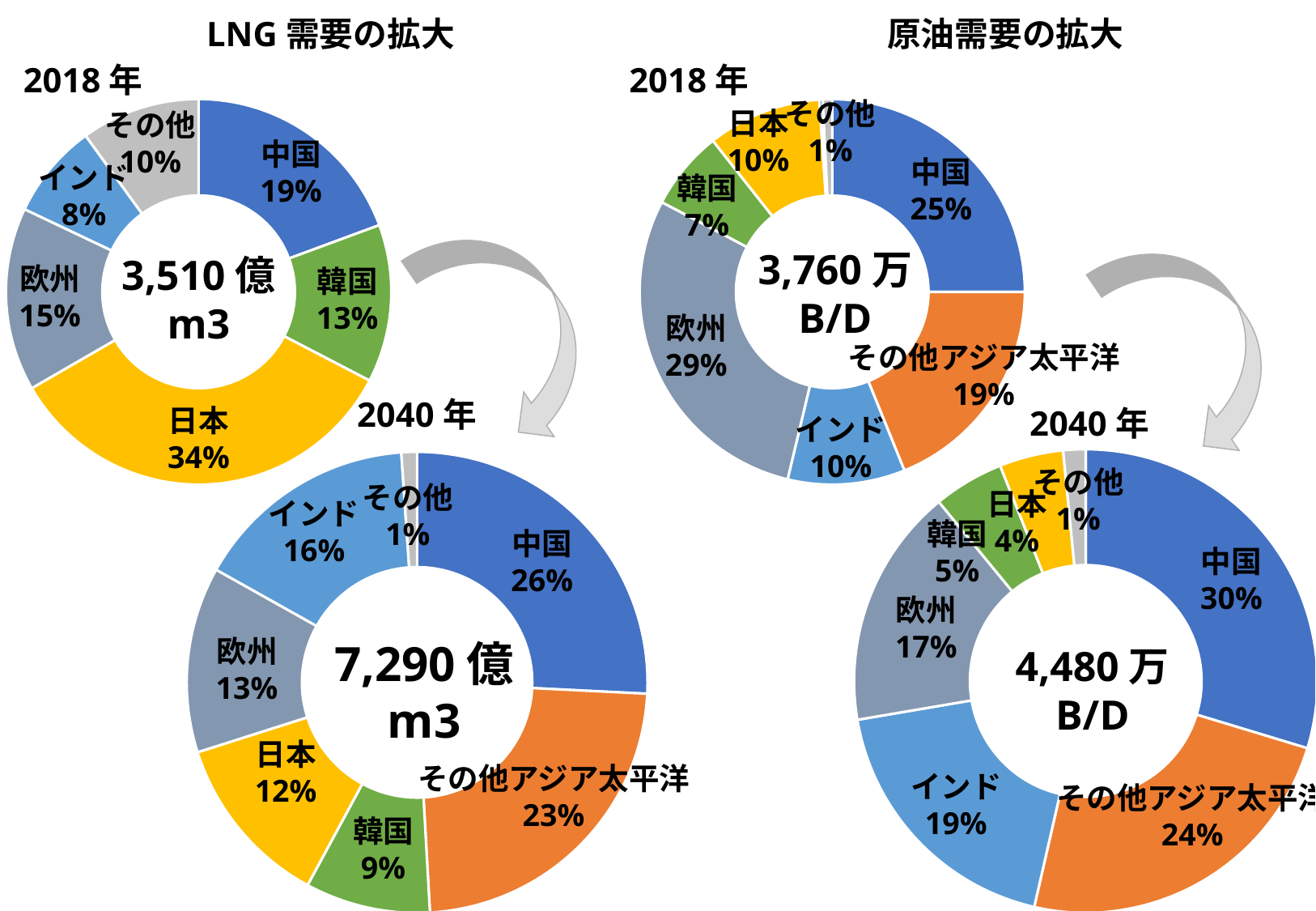
In the 原油需要の拡大 2018年 chart, what is the difference between the shares of 中国 and インド? 15% In the LNG需要の拡大 2040年 chart, what share does その他アジア太平洋 have? 23% What total value is shown in the center of the 原油需要の拡大 2040年 chart? 4,480万B/D In the LNG需要の拡大 2018年 chart, what share does 日本 have? 34% In the LNG需要の拡大 2018年 chart, which category has the largest share? 日本 In the 原油需要の拡大 2018年 chart, which category has the largest share? 欧州 In the LNG需要の拡大 2040年 chart, how many categories are shown? 7 In the 原油需要の拡大 2040年 chart, what share does 中国 have? 30% What type of chart is used for the LNG需要の拡大 2018年 data? Donut (pie) chart In the 原油需要の拡大 2040年 chart, which is larger, the share of インド or the share of 欧州? インド What total value is shown in the center of the LNG需要の拡大 2040年 chart? 7,290億m3 In the LNG需要の拡大 2018年 chart, which category has the smallest share? インド